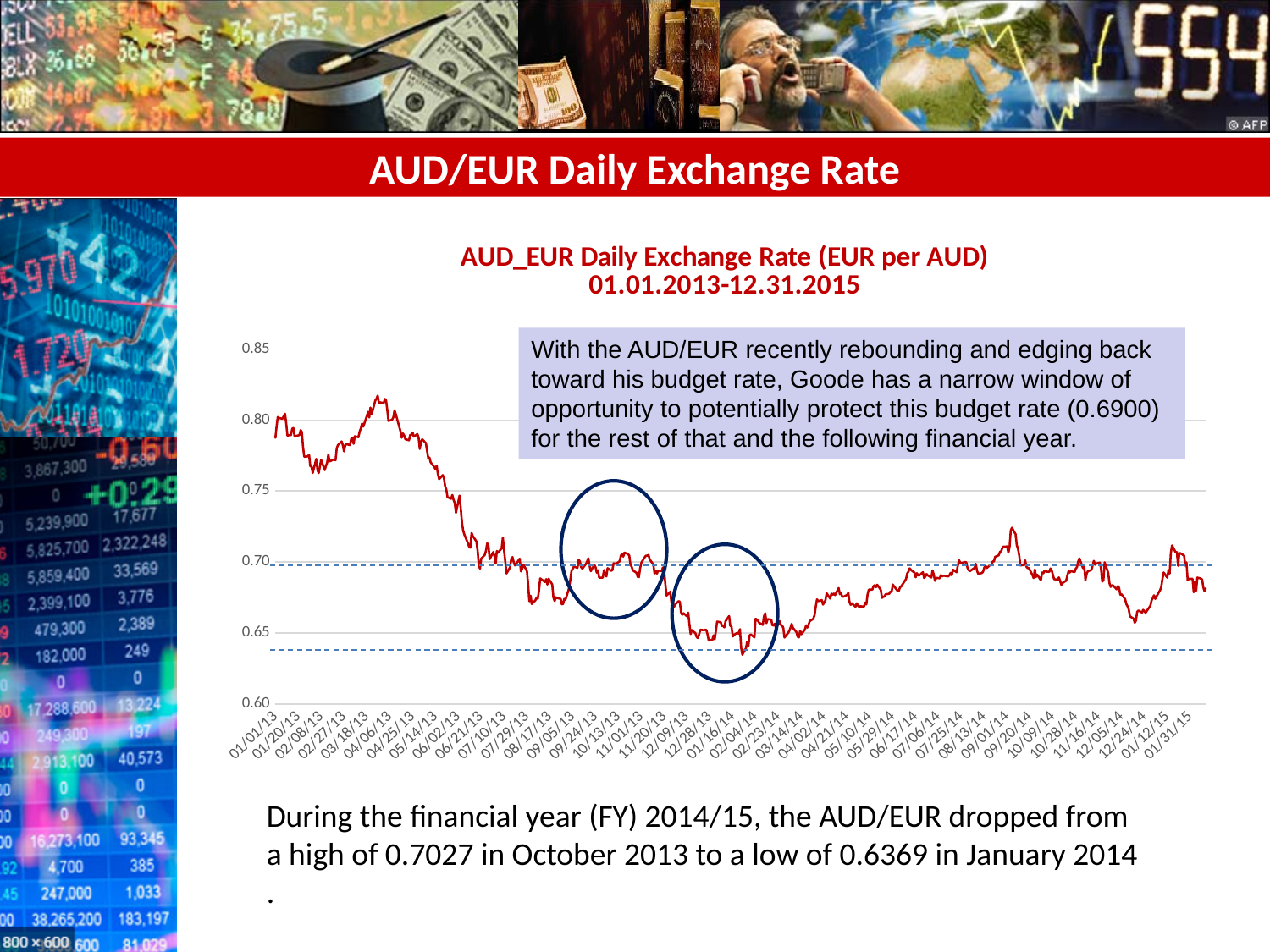
What is the highest value shown on the vertical axis of the chart? 0.85 What kind of chart is shown on the slide? line chart Between 04/06/13 and 08/17/13, does the exchange rate rise or fall? fall Is the exchange rate at the start of the chart (01/01/13) greater or less than 0.75? greater Overall, does the exchange rate rise or fall from the start of the chart to the end? fall How many data series (lines) are plotted on the chart? 1 What is the title of the chart? AUD_EUR Daily Exchange Rate (EUR per AUD) 01.01.2013-12.31.2015 According to the slide text, what high did the AUD/EUR reach in October 2013? 0.7027 According to the slide text, what low did the AUD/EUR reach in January 2014? 0.6369 Is the exchange rate around 12/24/14 greater or less than 0.70? less